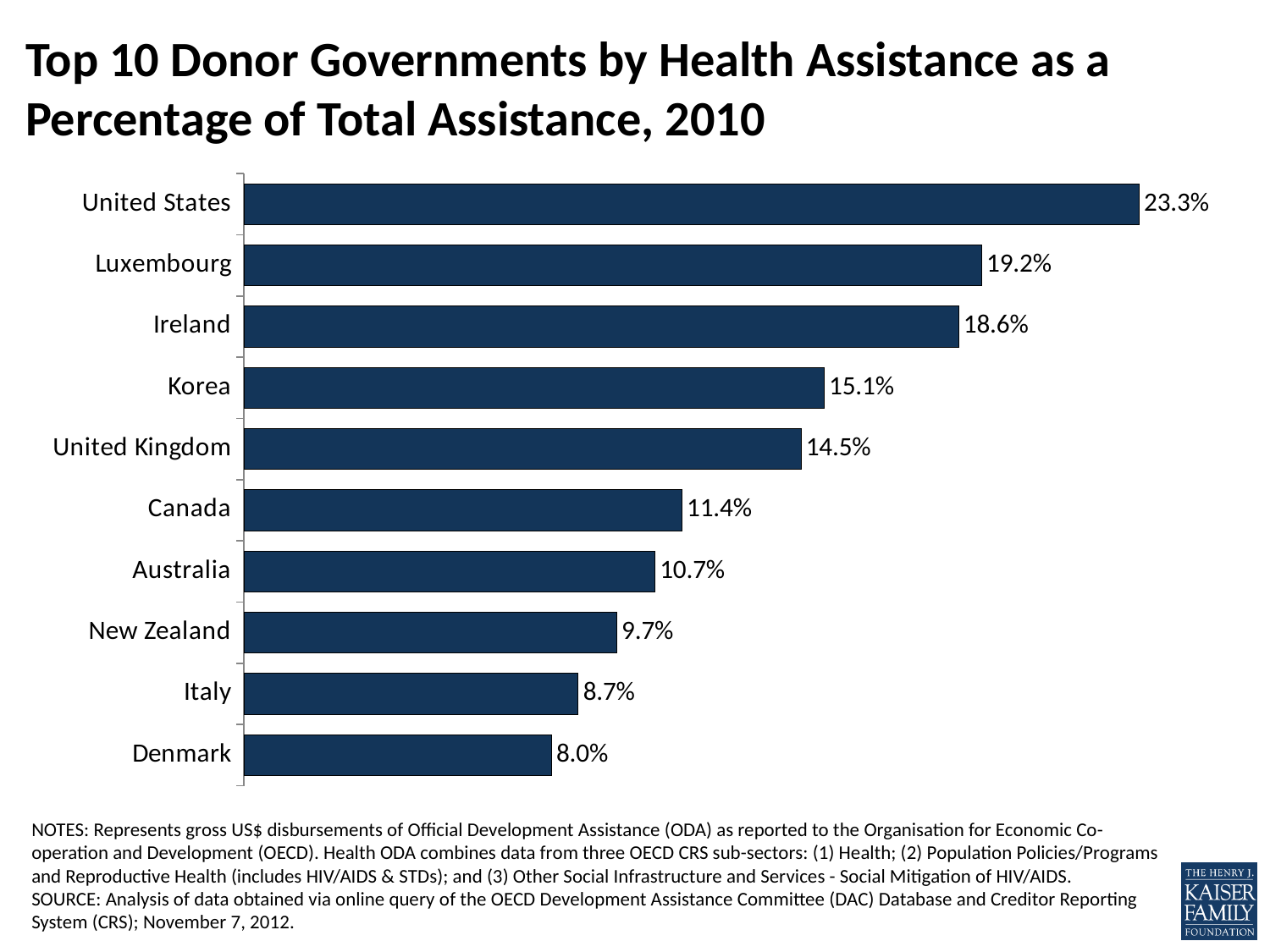
Which donor government has the highest health assistance as a percentage of total assistance? United States What is the difference between the values for Luxembourg and Ireland? 0.6% What is the title of the chart? Top 10 Donor Governments by Health Assistance as a Percentage of Total Assistance, 2010 Which has a larger value, Italy or the United Kingdom? United Kingdom What is the value for New Zealand? 9.7% How many donor governments are shown on the chart? 10 Which donor government has the lowest value on the chart? Denmark What is the difference between the values for the United States and Denmark? 15.3% What is the value for the United States? 23.3% What is the value for Korea? 15.1% What kind of chart is shown on the slide? Bar chart Which has a larger value, Canada or Australia? Canada